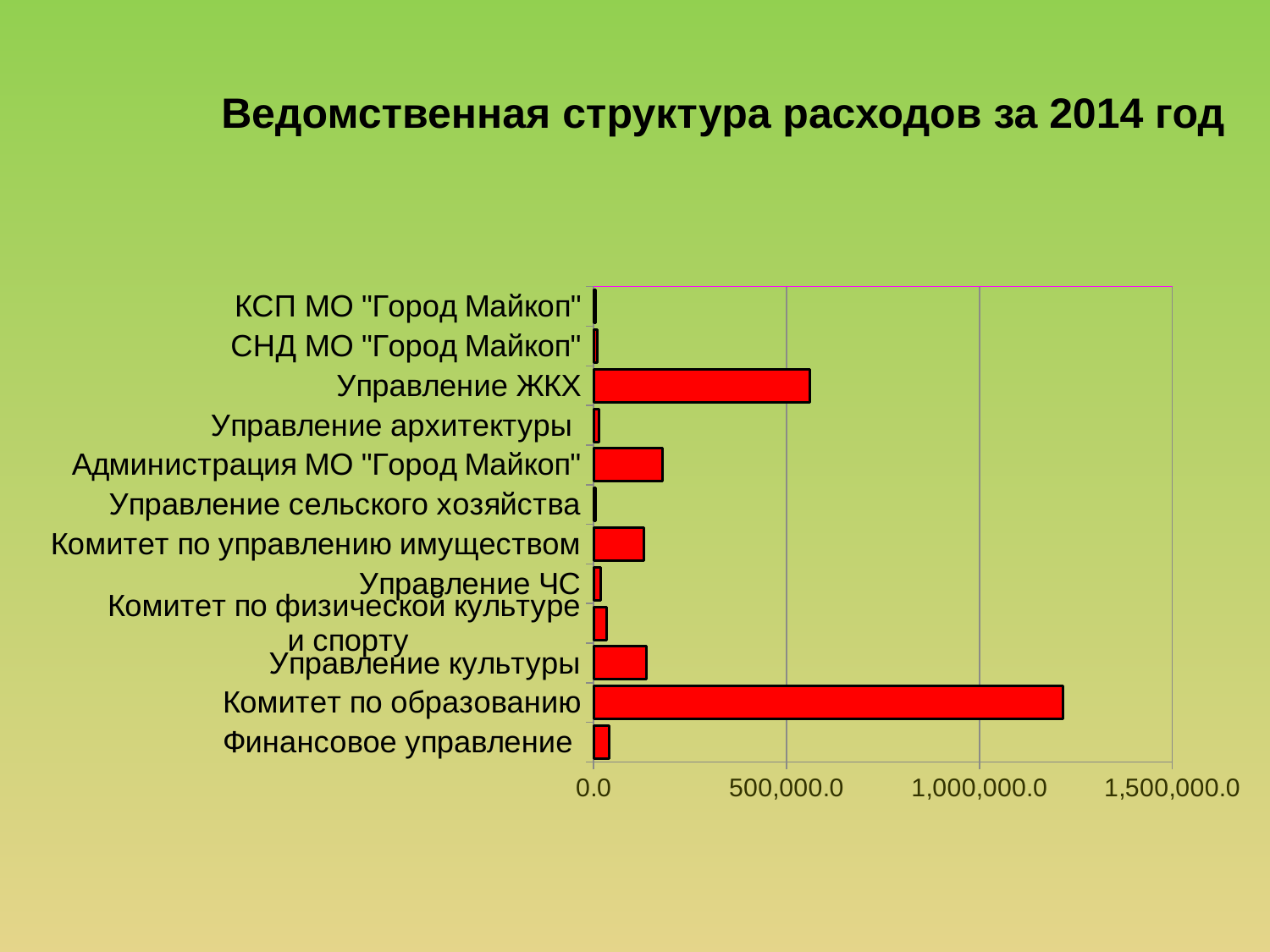
How many categories are plotted in the chart? 12 Is the value for Комитет по управлению имуществом greater or less than 500,000.0? less Is the value for Администрация МО "Город Майкоп" greater or less than 500,000.0? less Which is larger: the value for Управление культуры or the value for Финансовое управление? Управление культуры Which category has the highest value in the chart? Комитет по образованию Which is larger: the value for Управление ЖКХ or the value for Администрация МО "Город Майкоп"? Управление ЖКХ Is the value for Комитет по образованию greater or less than 1,000,000.0? greater What kind of chart is shown on the slide? bar chart What is the title of the chart on the slide? Ведомственная структура расходов за 2014 год Which is larger: the value for Комитет по образованию or the value for Управление ЖКХ? Комитет по образованию What colour are the bars in the chart? red